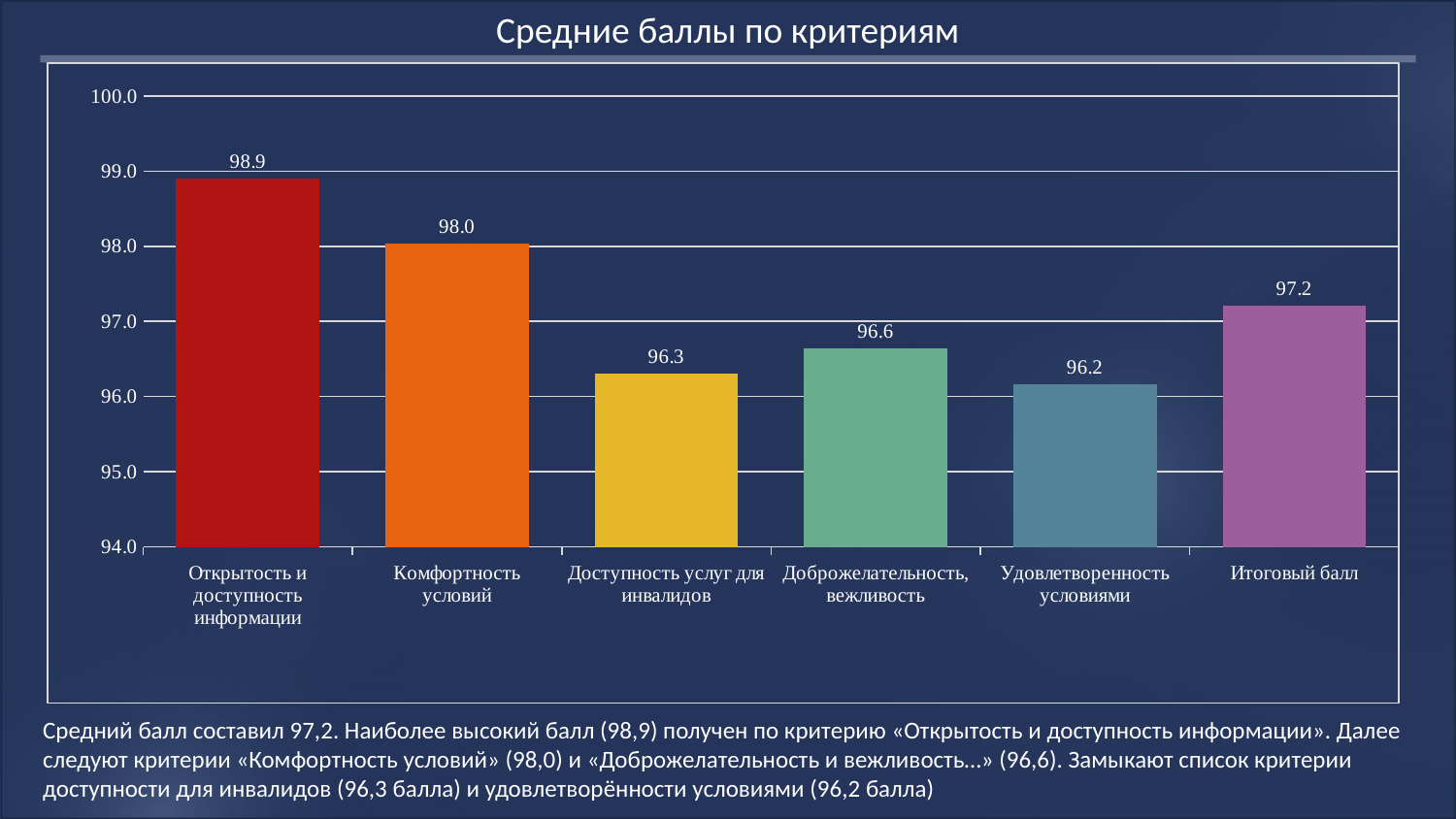
How many categories are shown on the chart? 6 Is the value for «Доступность услуг для инвалидов» greater or less than 97.0? less What kind of chart is shown on the slide? bar chart Which category has the highest value? Открытость и доступность информации What is the value for «Итоговый балл»? 97.2 What is the value for «Доброжелательность, вежливость»? 96.6 What is the title of the chart? Средние баллы по критериям Which is larger: the value for «Комфортность условий» or the value for «Итоговый балл»? Комфортность условий What is the difference between the values for «Доброжелательность, вежливость» and «Удовлетворенность условиями»? 0.4 What is the value for «Открытость и доступность информации»? 98.9 Which category has the lowest value? Удовлетворенность условиями What is the difference between the values for «Открытость и доступность информации» and «Комфортность условий»? 0.9